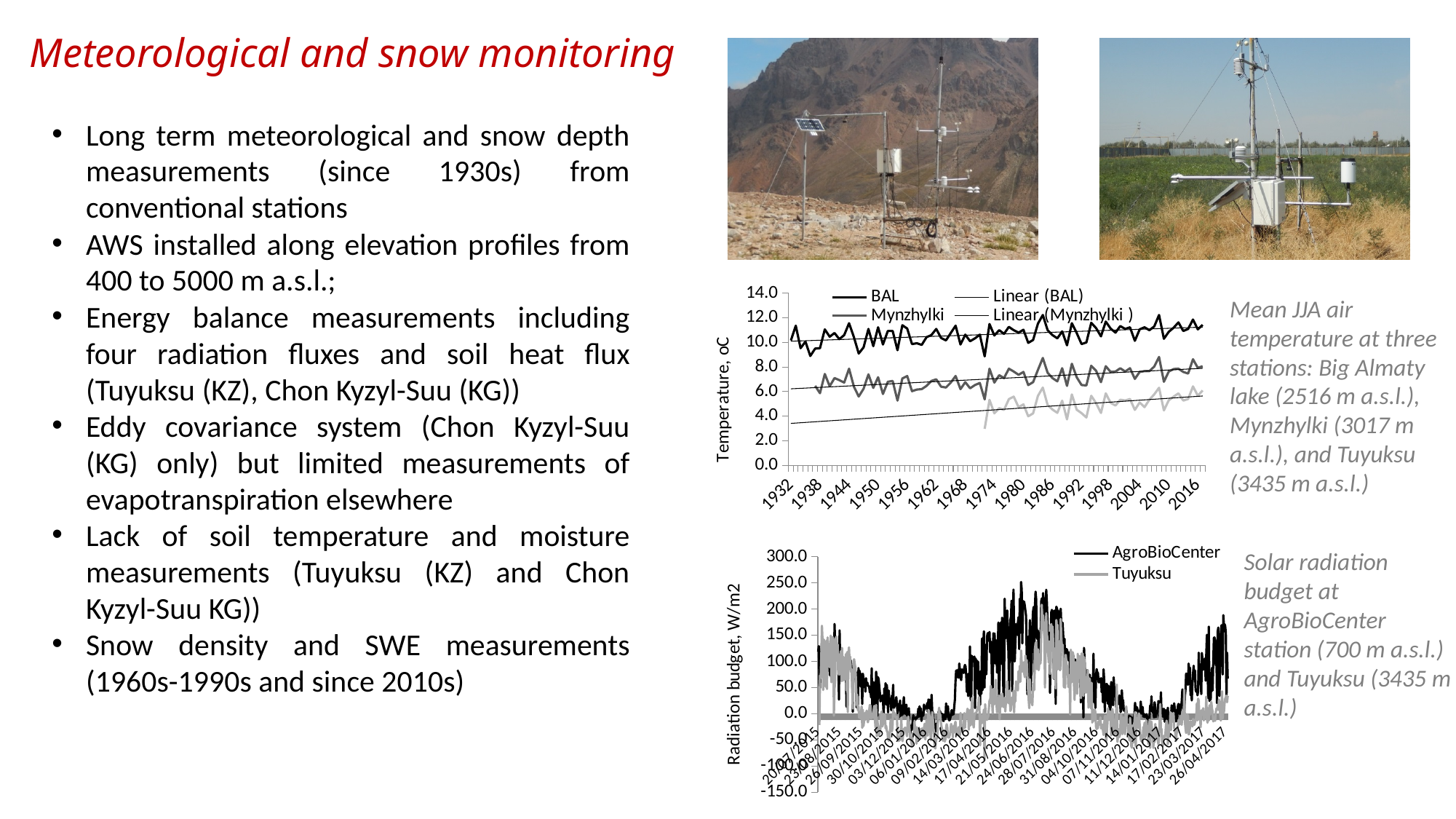
What kind of chart is the upper chart showing temperature? line chart In the upper temperature chart, are the BAL values greater or less than 8.0? greater How many series does the legend of the lower radiation budget chart list? 2 How many series does the legend of the upper temperature chart list? 4 In the upper temperature chart, does the Linear (Mynzhylki) trend line rise or fall from 1932 to 2016? rise What is the y-axis label of the lower radiation budget chart? Radiation budget, W/m2 What kind of chart is the lower chart showing radiation budget? line chart In the upper temperature chart, which series has higher values, BAL or Mynzhylki? BAL What is the first year label on the x axis of the upper temperature chart? 1932 In the lower radiation budget chart, is the peak value for AgroBioCenter greater or less than 200.0? greater In the upper temperature chart, are the Mynzhylki values greater or less than 10.0? less In the lower radiation budget chart, which series reaches higher values in summer 2016, AgroBioCenter or Tuyuksu? AgroBioCenter